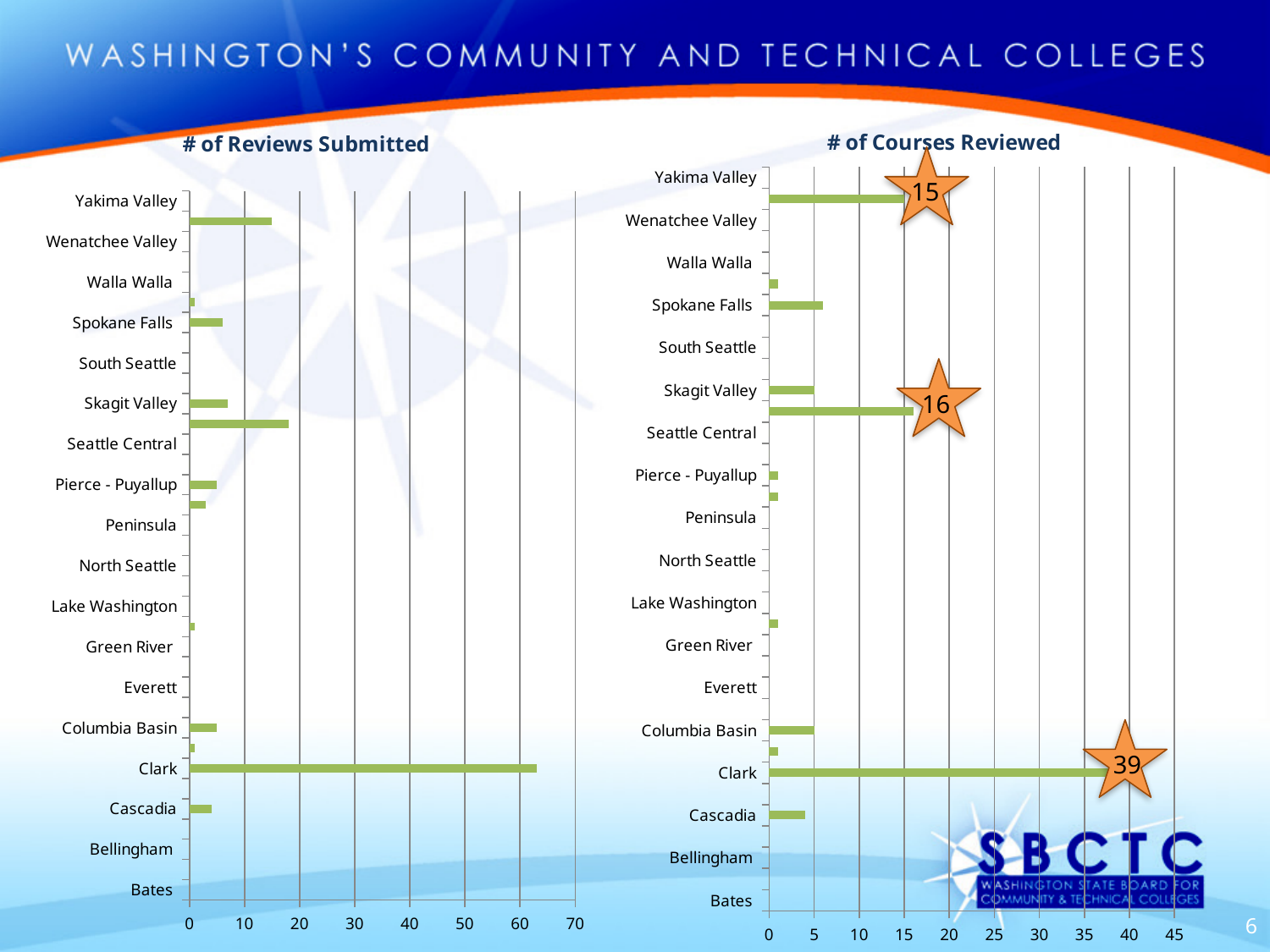
In the "# of Reviews Submitted" chart, is the value for Cascadia greater or less than 10? less In the "# of Courses Reviewed" chart, what value is labelled for Clark? 39 What kind of chart is the "# of Reviews Submitted" chart? Bar chart In the "# of Reviews Submitted" chart, which is larger, the value for Clark or the value for Cascadia? Clark What is the highest tick value shown on the x axis of the "# of Courses Reviewed" chart? 45 What is the title of the chart on the left side of the slide? # of Reviews Submitted In the "# of Reviews Submitted" chart, which college has the highest value? Clark How many colleges are listed on the y axis of the "# of Courses Reviewed" chart? 18 In the "# of Courses Reviewed" chart, which college has the highest value? Clark In the "# of Reviews Submitted" chart, is the value for Clark greater or less than 60? greater In the "# of Courses Reviewed" chart, which is larger, the value for Clark or the value for Columbia Basin? Clark In the "# of Courses Reviewed" chart, is the value for Spokane Falls greater or less than 10? less